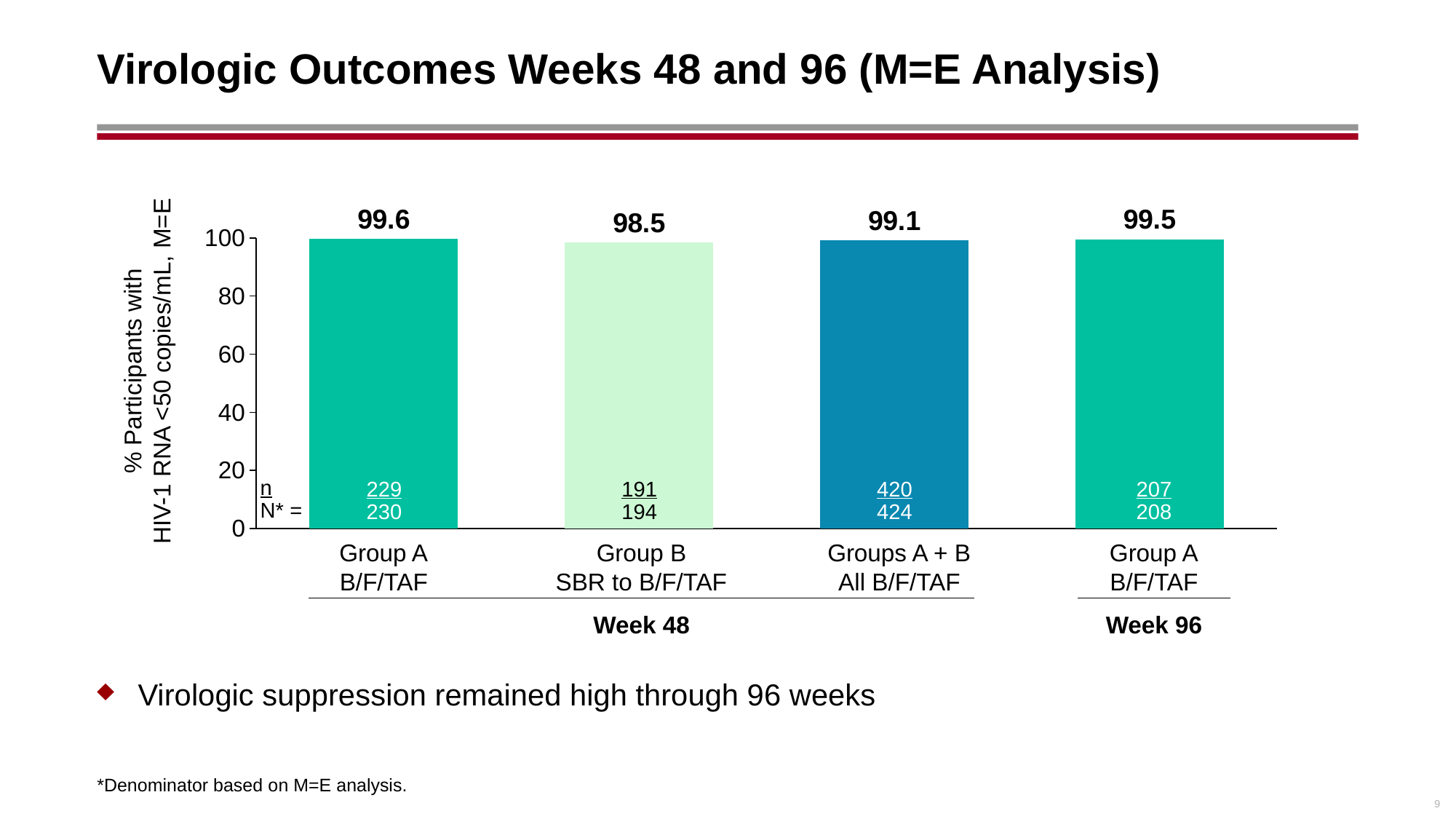
Which is larger: the Week 48 Groups A + B value or the Week 48 Group B value? Groups A + B What is the value for Group A B/F/TAF at Week 96? 99.5 What is the N* value shown for the Group A B/F/TAF bar at Week 96? 208 Which bar has the lowest value? Group B SBR to B/F/TAF, Week 48 How many bars are shown in the chart? 4 What is the n value shown for the Groups A + B All B/F/TAF bar? 420 What is the value for Group A B/F/TAF at Week 48? 99.6 What is the value for Group B SBR to B/F/TAF at Week 48? 98.5 Which bar has the highest value? Group A B/F/TAF, Week 48 What is the value for Groups A + B All B/F/TAF at Week 48? 99.1 What kind of chart is shown on the slide? Bar chart What is the difference between the Week 48 Group A value and the Week 48 Group B value? 1.1